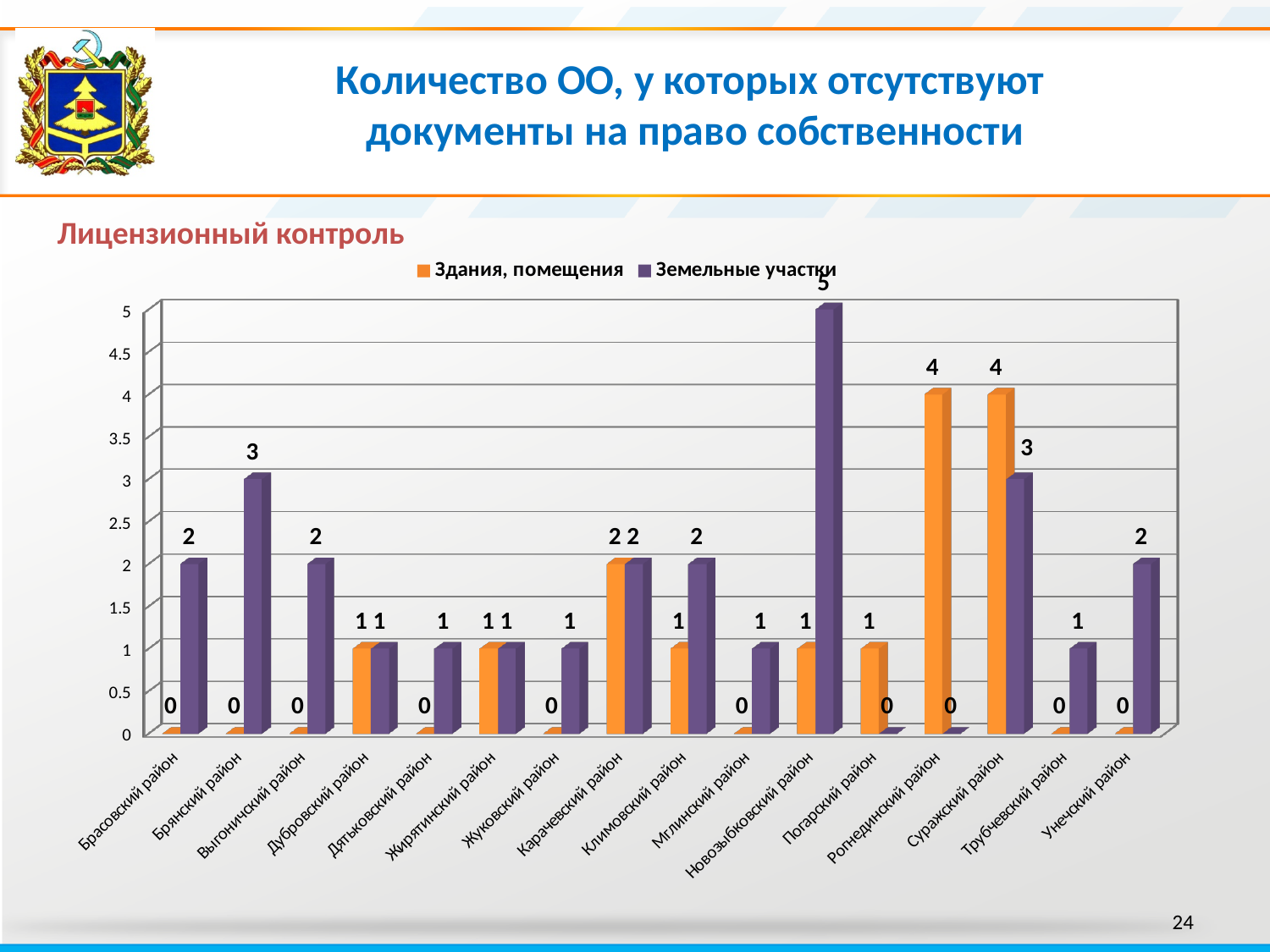
How many districts (categories) are shown on the x axis? 16 Which series is shown in orange in the legend? Здания, помещения What is the value for Здания, помещения in Погарский район? 1 What is the value for Земельные участки in Брянский район? 3 Which district has the highest value for Земельные участки? Новозыбковский район What is the value for Здания, помещения in Рогнединский район? 4 What is the difference between Здания, помещения and Земельные участки in Суражский район? 1 What is the value for Земельные участки in Новозыбковский район? 5 How many series does the legend list? 2 What is the value for Земельные участки in Унечский район? 2 Which is larger in Климовский район: Здания, помещения or Земельные участки? Земельные участки What type of chart is shown on the slide? bar chart